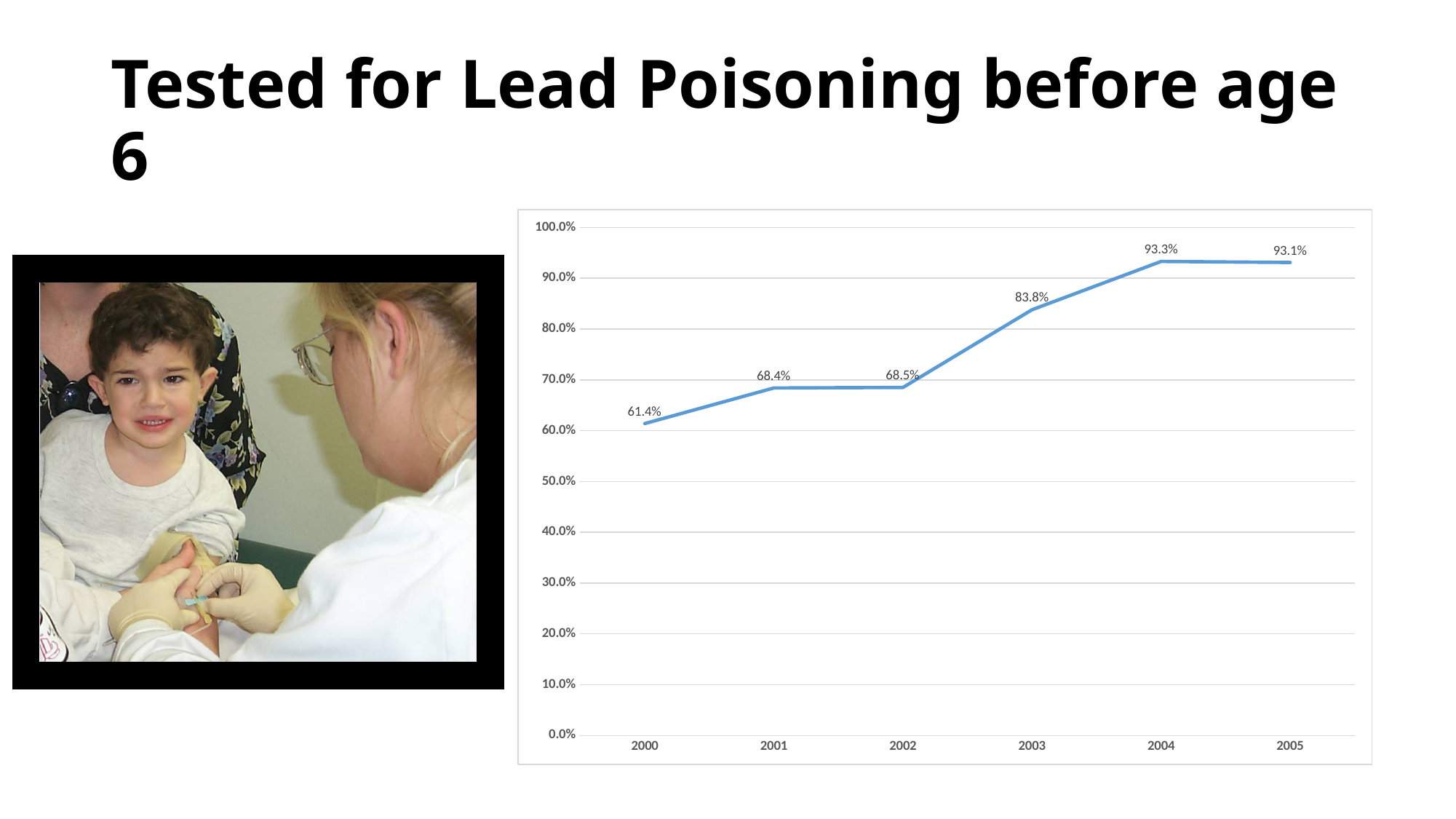
Is the value for 2002 greater or less than 80.0%? less Do the values generally rise or fall from 2000 to 2005? rise Which year has the highest value? 2004 What is the difference between the values for 2003 and 2002? 15.3% How many years are plotted on the x axis? 6 What kind of chart is shown? line chart Which is larger, the value for 2001 or the value for 2003? 2003 What is the value for 2005? 93.1% Which year has the lowest value? 2000 What is the value for 2003? 83.8% What is the difference between the values for 2004 and 2000? 31.9% What is the value for 2000? 61.4%